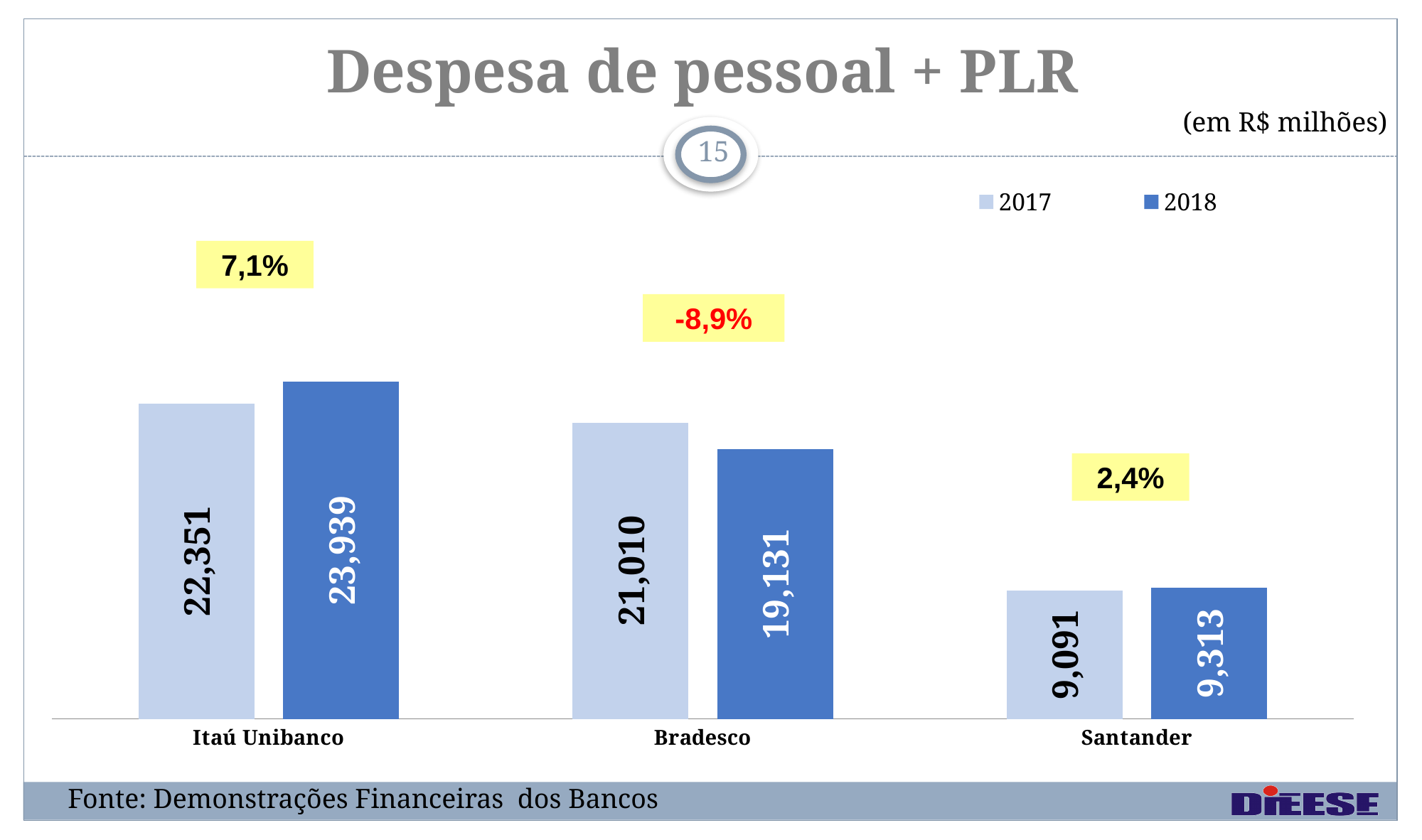
What is the difference between the 2018 and 2017 values for Itaú Unibanco? 1,588 Which bank has the highest 2018 value? Itaú Unibanco What is the 2018 value for Santander? 9,313 What is the difference between the 2018 and 2017 values for Bradesco? 1,879 What is the 2018 value for Itaú Unibanco? 23,939 How many banks are shown on the x axis? 3 What kind of chart is shown on the slide? Bar chart What percentage change is shown above the Bradesco bars? -8,9% Which bank has the lowest 2017 value? Santander How many series does the legend list? 2 What is the 2017 value for Bradesco? 21,010 Which is larger for Bradesco, the 2017 value or the 2018 value? 2017